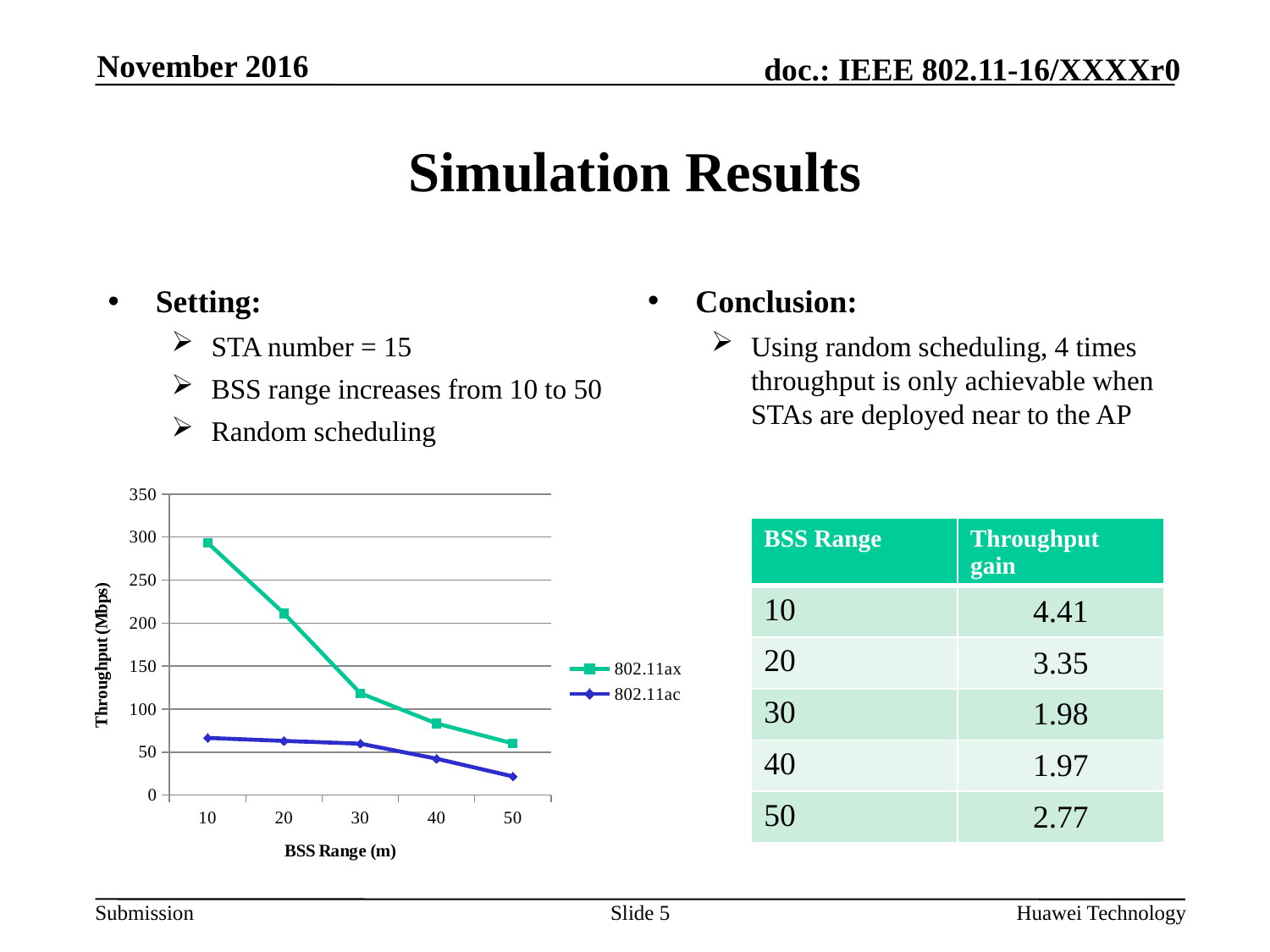
How many BSS Range values are plotted along the x axis of the chart? 5 Is the 802.11ax throughput at BSS Range 10 greater or less than 250? greater At which BSS Range does the 802.11ax series reach its highest throughput? 10 Is the 802.11ax throughput at BSS Range 40 greater or less than 100? less Is the 802.11ax throughput at BSS Range 30 greater or less than 150? less Does the 802.11ax throughput rise or fall as BSS Range increases from 10 to 50? Fall At BSS Range 10, which series has the higher throughput, 802.11ax or 802.11ac? 802.11ax What is the label of the chart's vertical axis? Throughput (Mbps) What kind of chart is shown on the slide? Line chart How many series does the chart legend list? 2